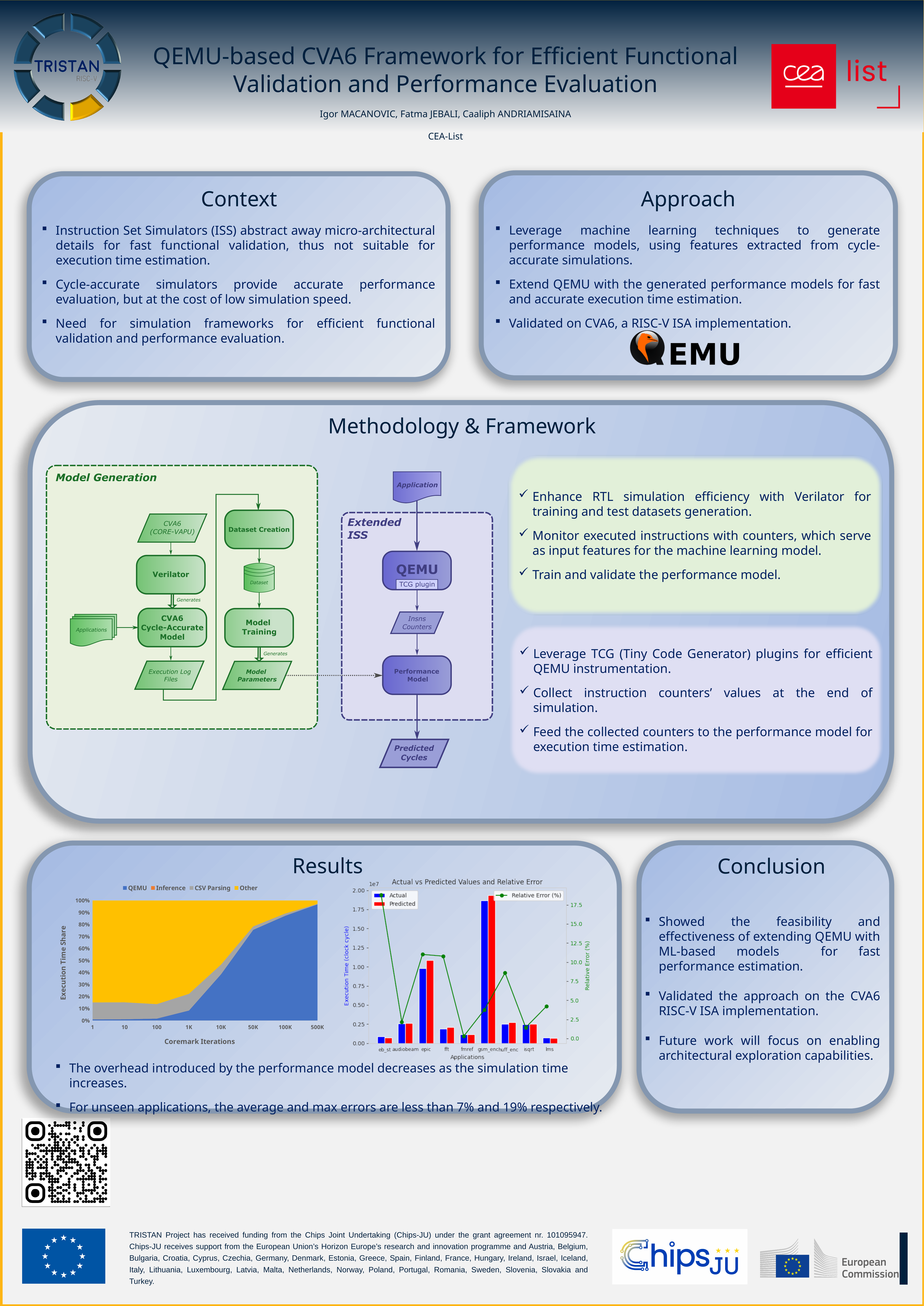
What is the title of the right chart in the Results section? Actual vs Predicted Values and Relative Error In the left chart in the Results section, what are the four legend entries? QEMU, Inference, CSV Parsing, Other In the chart titled 'Actual vs Predicted Values and Relative Error', which application has the highest relative error? eb_st In the chart titled 'Actual vs Predicted Values and Relative Error', which application has the highest actual execution time? gsm_enc In the chart titled 'Actual vs Predicted Values and Relative Error', how many applications are shown on the x axis? 9 In the left chart in the Results section, how many series does the legend list? 4 In the left chart in the Results section, is the Other execution time share at 1 iteration greater or less than 70%? greater In the left chart in the Results section, does the QEMU share of execution time rise or fall as Coremark iterations increase? rise In the chart titled 'Actual vs Predicted Values and Relative Error', how many series does the legend list? 3 In the left chart in the Results section, is the QEMU execution time share at 500K iterations greater or less than 90%? greater In the left chart in the Results section, how many Coremark iteration values are marked on the x axis? 8 In the chart titled 'Actual vs Predicted Values and Relative Error', which has the larger actual execution time, epic or fft? epic